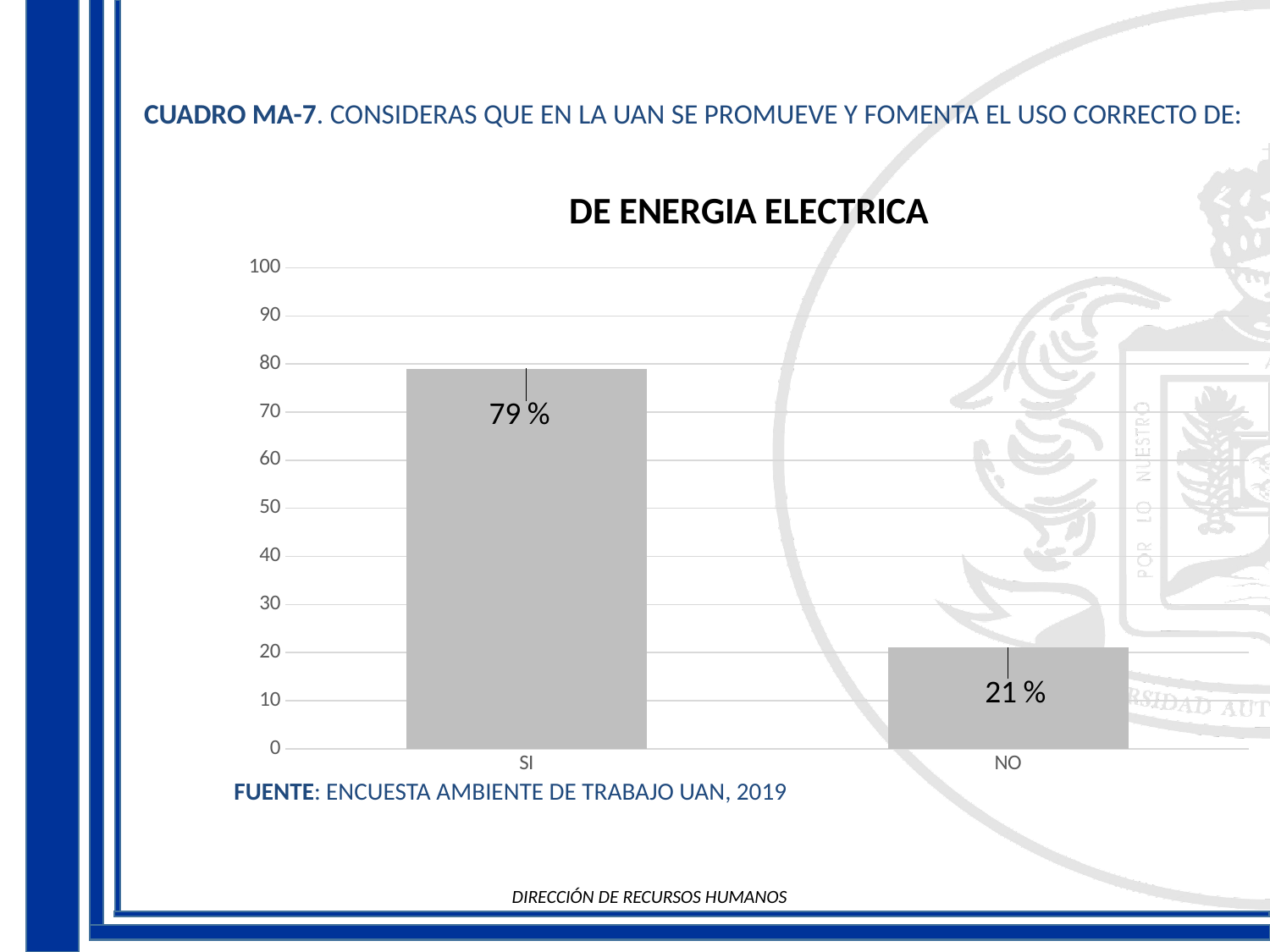
What is the difference between the values for SI and NO? 58 % Which category has the highest value? SI Which category has the lowest value? NO Is the value for NO greater or less than 30? less Which is larger, the value for SI or the value for NO? SI What is the value for NO? 21 % How many categories are shown on the x axis? 2 What kind of chart is shown? bar chart What is the title of the chart? DE ENERGIA ELECTRICA Is the value for SI greater or less than 70? greater What is the maximum value shown on the y axis? 100 What is the value for SI? 79 %